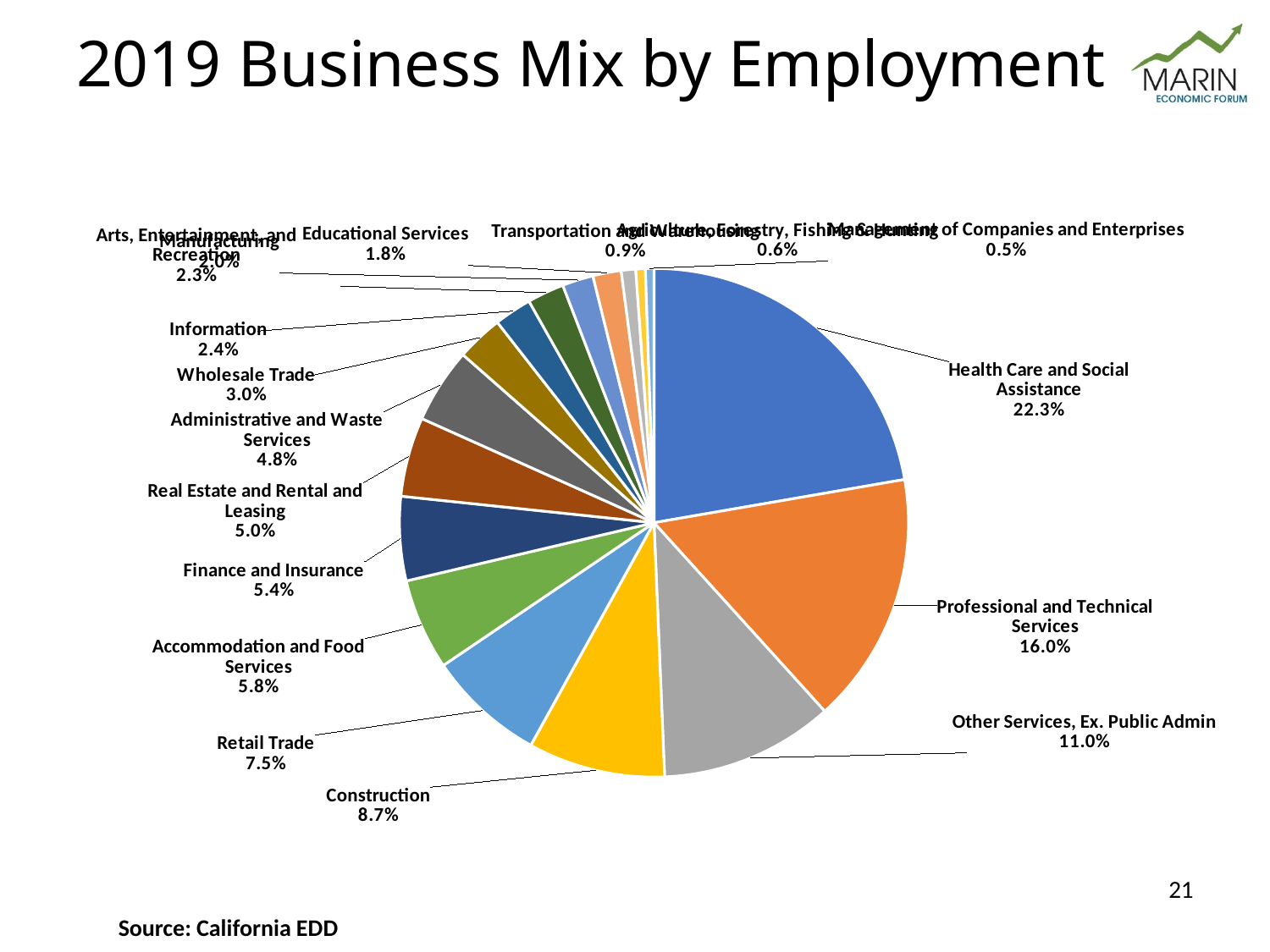
What is the combined share of Retail Trade and Construction? 16.2% What percentage is shown for Construction? 8.7% What is the difference in percentage points between Health Care and Social Assistance and Professional and Technical Services? 6.3 What share is shown for Management of Companies and Enterprises? 0.5% What is the value shown for Professional and Technical Services? 16.0% What share of employment does Health Care and Social Assistance account for? 22.3% Which sector has the largest share of employment in the pie chart? Health Care and Social Assistance What is the title of the chart on the slide? 2019 Business Mix by Employment Which has a larger share: Finance and Insurance or Accommodation and Food Services? Accommodation and Food Services What type of chart is shown on the slide? Pie chart Which labelled sector has the smallest share of employment? Management of Companies and Enterprises What is the value for Retail Trade? 7.5%